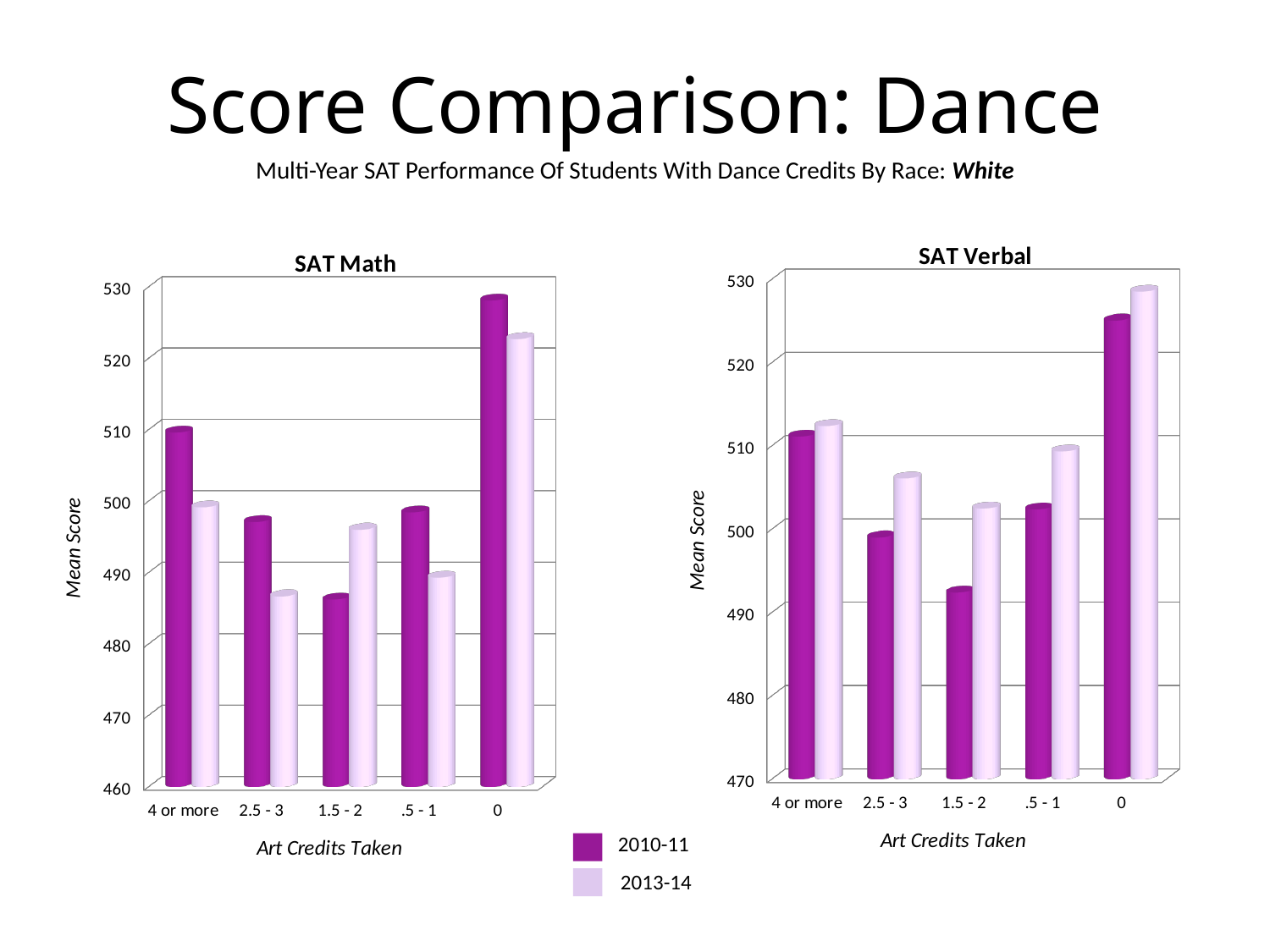
In the SAT Math chart, for the 4 or more category, which series has the larger value, 2010-11 or 2013-14? 2010-11 In the SAT Verbal chart, which art-credit category has the lowest 2010-11 mean score? 1.5 - 2 In the SAT Verbal chart, which art-credit category has the highest 2013-14 mean score? 0 How many art-credit categories are shown on the x axis of the SAT Verbal chart? 5 What is the y-axis label on the SAT Verbal chart? Mean Score In the SAT Verbal chart, for the 2.5 - 3 category, which series has the larger value, 2010-11 or 2013-14? 2013-14 What kind of chart is the SAT Math chart? bar chart How many series does the legend list? 2 In the SAT Math chart, is the 2010-11 value for the 0 credits category greater or less than 520? greater In the SAT Math chart, is the 2013-14 value for the 2.5 - 3 category greater or less than 490? less In the SAT Math chart, which art-credit category has the lowest 2010-11 mean score? 1.5 - 2 In the SAT Math chart, which art-credit category has the highest 2010-11 mean score? 0